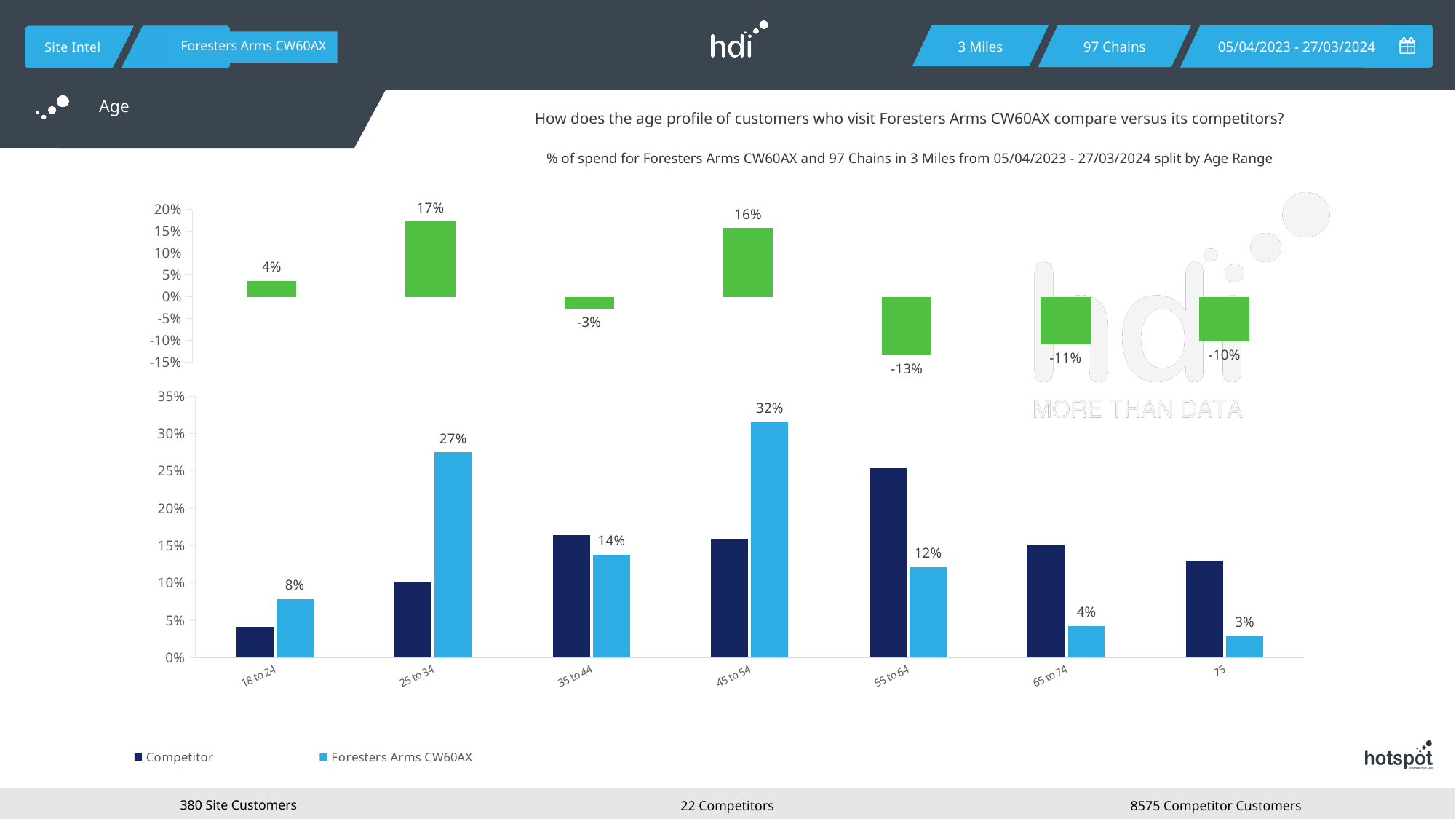
In the top chart, what is the lowest value shown? -13% In the bottom chart, for the 55 to 64 age range, which is larger: Competitor or Foresters Arms CW60AX? Competitor In the bottom chart, what is the value for Foresters Arms CW60AX in the 45 to 54 age range? 32% In the bottom chart, what is the value for Foresters Arms CW60AX in the 25 to 34 age range? 27% How many series does the legend of the bottom chart list? 2 In the bottom chart, which age range has the highest value for Foresters Arms CW60AX? 45 to 54 In the bottom chart, what is the difference between the Foresters Arms CW60AX values for 45 to 54 and 25 to 34? 5% In the bottom chart, is the Competitor value for 55 to 64 greater or less than 20%? greater How many age range categories are shown on the x axis of the bottom chart? 7 In the top chart, what is the highest value shown? 17% What kind of chart is the bottom chart? bar chart In the bottom chart, which age range has the lowest value for Foresters Arms CW60AX? 75